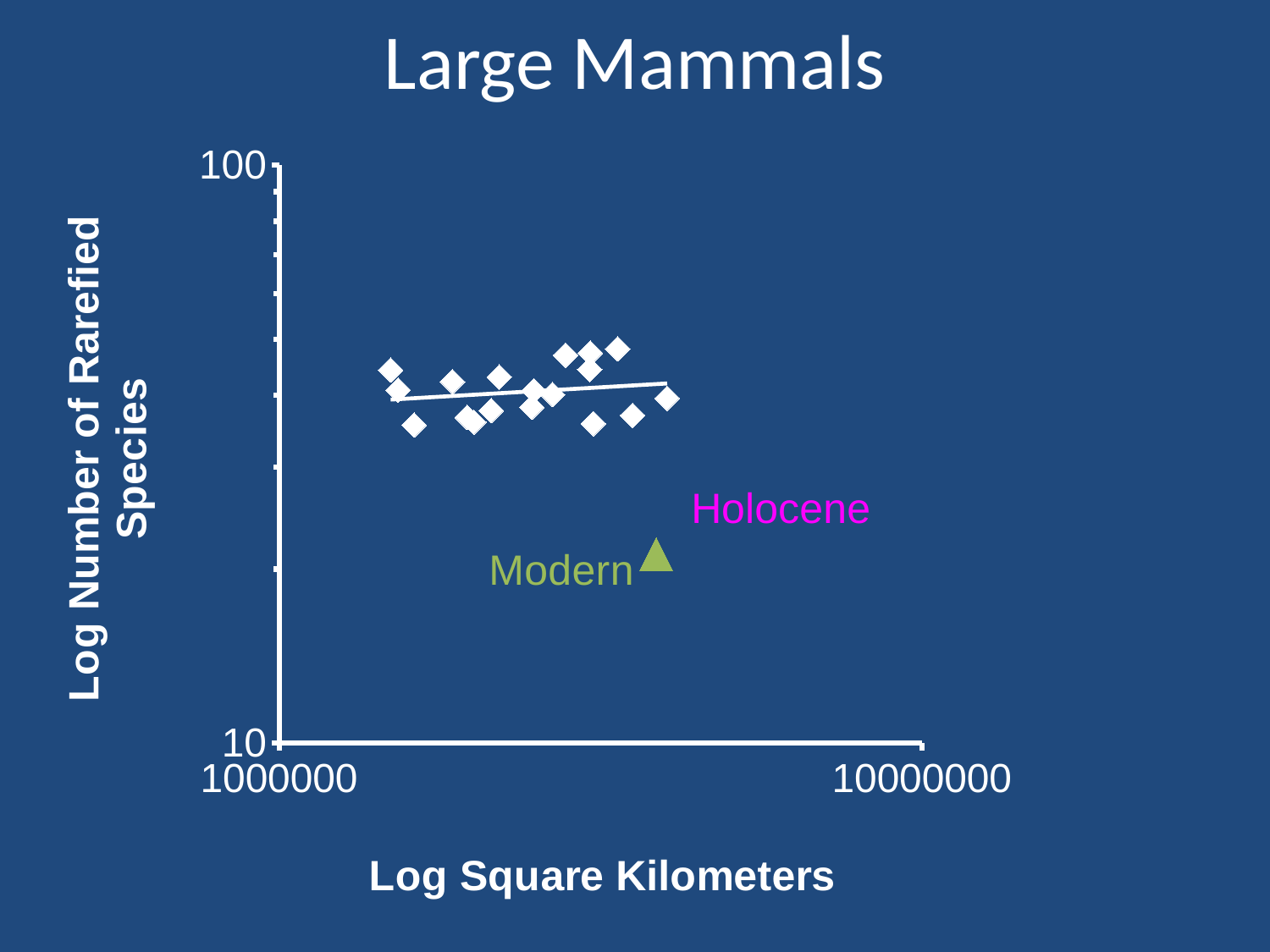
What is the lowest value labelled on the y axis? 10 Is the value for the Modern point greater or less than 10? greater What is the label of the y axis? Log Number of Rarefied Species How many groups of points are labelled on the chart? 2 What is the largest value labelled on the x axis? 10000000 What is the smallest value labelled on the x axis? 1000000 What is the highest value labelled on the y axis? 100 What is the label of the x axis? Log Square Kilometers What is the title of the chart? Large Mammals Is the value for the Modern point greater or less than 100? less What kind of chart is shown on the slide? Scatter plot